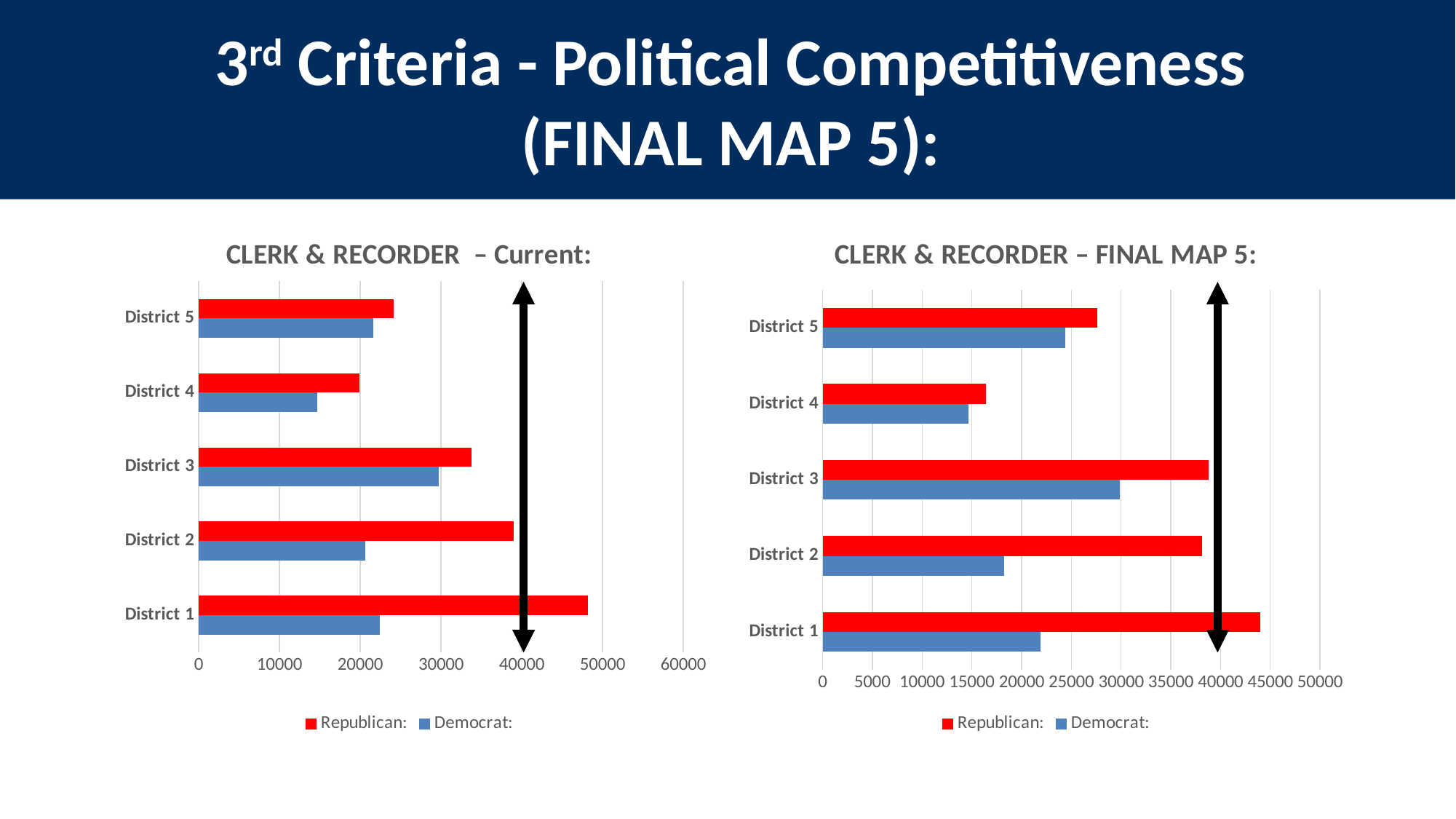
On the CLERK & RECORDER – Current chart, is the Republican value for District 1 greater or less than 40000? greater On the CLERK & RECORDER – Current chart, how many districts are plotted? 5 On the CLERK & RECORDER – FINAL MAP 5 chart, what colour represents the Democrat series? blue On the CLERK & RECORDER – FINAL MAP 5 chart, which district has the highest Republican value? District 1 On the CLERK & RECORDER – FINAL MAP 5 chart, which district has the lowest Republican value? District 4 On the CLERK & RECORDER – FINAL MAP 5 chart, is the Republican value for District 3 greater or less than 35000? greater On the CLERK & RECORDER – Current chart, is the Democrat value for District 2 greater or less than 30000? less On the CLERK & RECORDER – Current chart, which district has the lowest Democrat value? District 4 On the CLERK & RECORDER – Current chart, what kind of chart is shown? bar chart On the CLERK & RECORDER – Current chart, which district has the highest Republican value? District 1 On the CLERK & RECORDER – Current chart, for District 3, which is larger: the Republican value or the Democrat value? Republican On the CLERK & RECORDER – Current chart, how many series does the legend list? 2